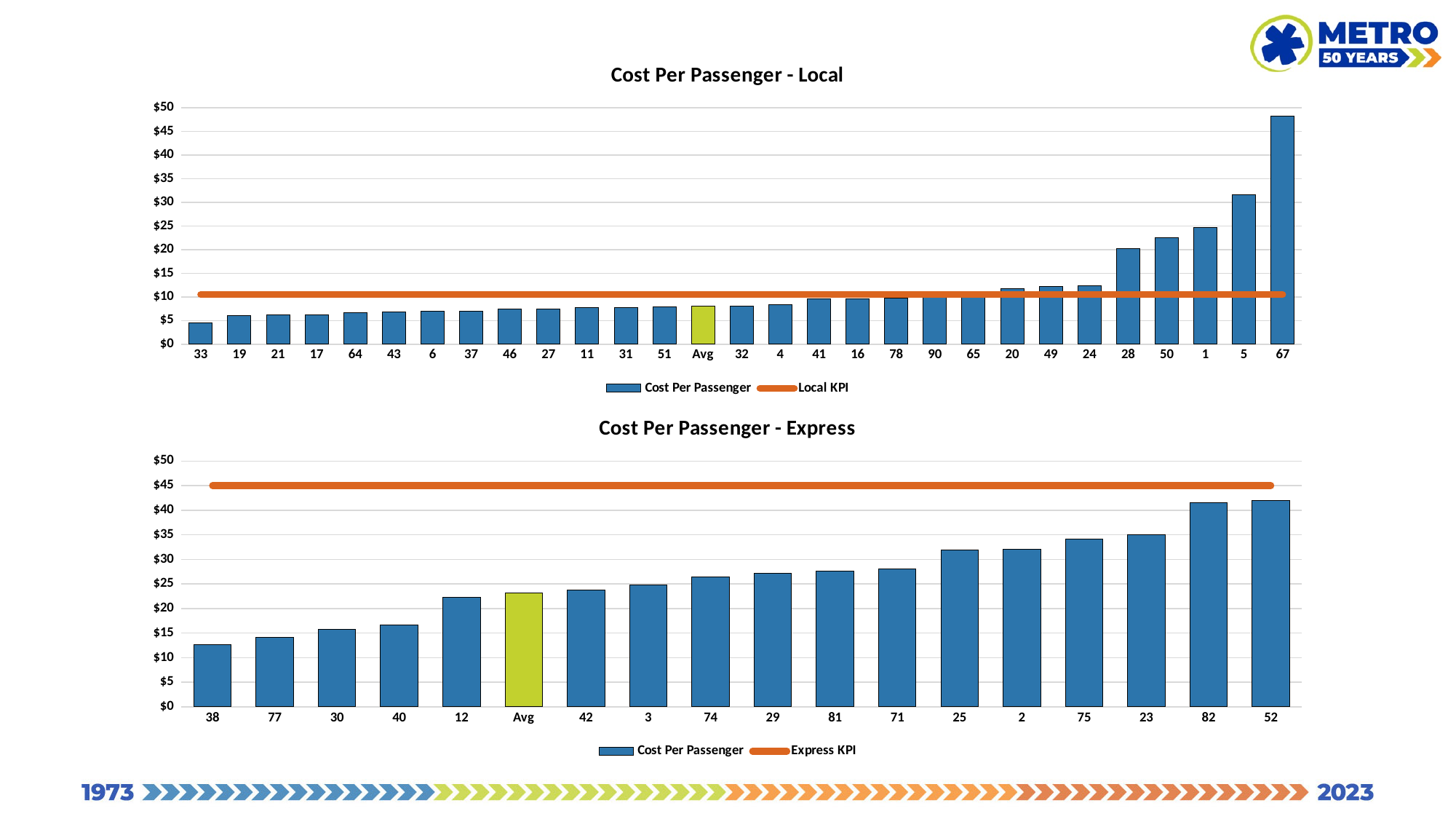
In the Cost Per Passenger - Local chart, is the value for route 67 greater or less than $45? greater In the Cost Per Passenger - Express chart, do the bar values rise or fall from left to right along the x axis? rise In the Cost Per Passenger - Express chart, is the value for route 25 greater or less than $30? greater In the Cost Per Passenger - Local chart, is the value for route 1 greater or less than $20? greater In the Cost Per Passenger - Local chart, which route has the lowest cost per passenger? 33 In the Cost Per Passenger - Express chart, which is larger, the value for route 23 or the value for route 42? 23 How many series does the legend of the Cost Per Passenger - Express chart list? 2 How many categories are shown on the x axis of the Cost Per Passenger - Express chart? 18 In the Cost Per Passenger - Local chart, which route has the highest cost per passenger? 67 In the Cost Per Passenger - Local chart, which is larger, the value for route 67 or the value for route 5? 67 How many categories are shown on the x axis of the Cost Per Passenger - Local chart? 29